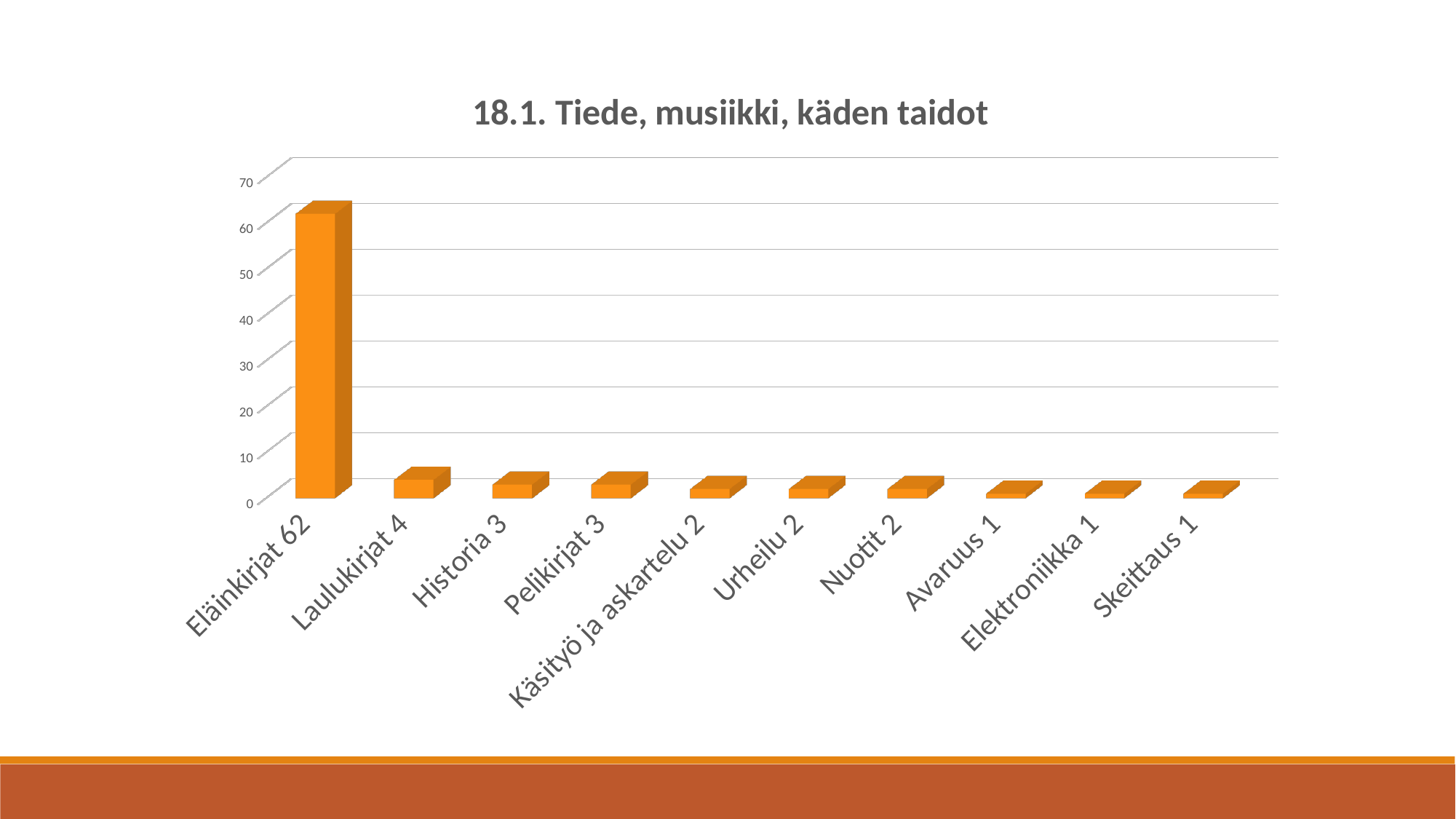
Which category has the highest value? Eläinkirjat What is the value for Laulukirjat? 4 Is the value for Eläinkirjat greater or less than 50? greater What is the value for Eläinkirjat? 62 What kind of chart is shown on the slide? bar chart What is the difference between the values for Laulukirjat and Historia? 1 Is the value for Historia greater or less than 10? less Which is larger, the value for Laulukirjat or the value for Avaruus? Laulukirjat How many categories are shown on the chart? 10 What is the title of the chart? 18.1. Tiede, musiikki, käden taidot What is the difference between the values for Eläinkirjat and Laulukirjat? 58 What is the value for Käsityö ja askartelu? 2